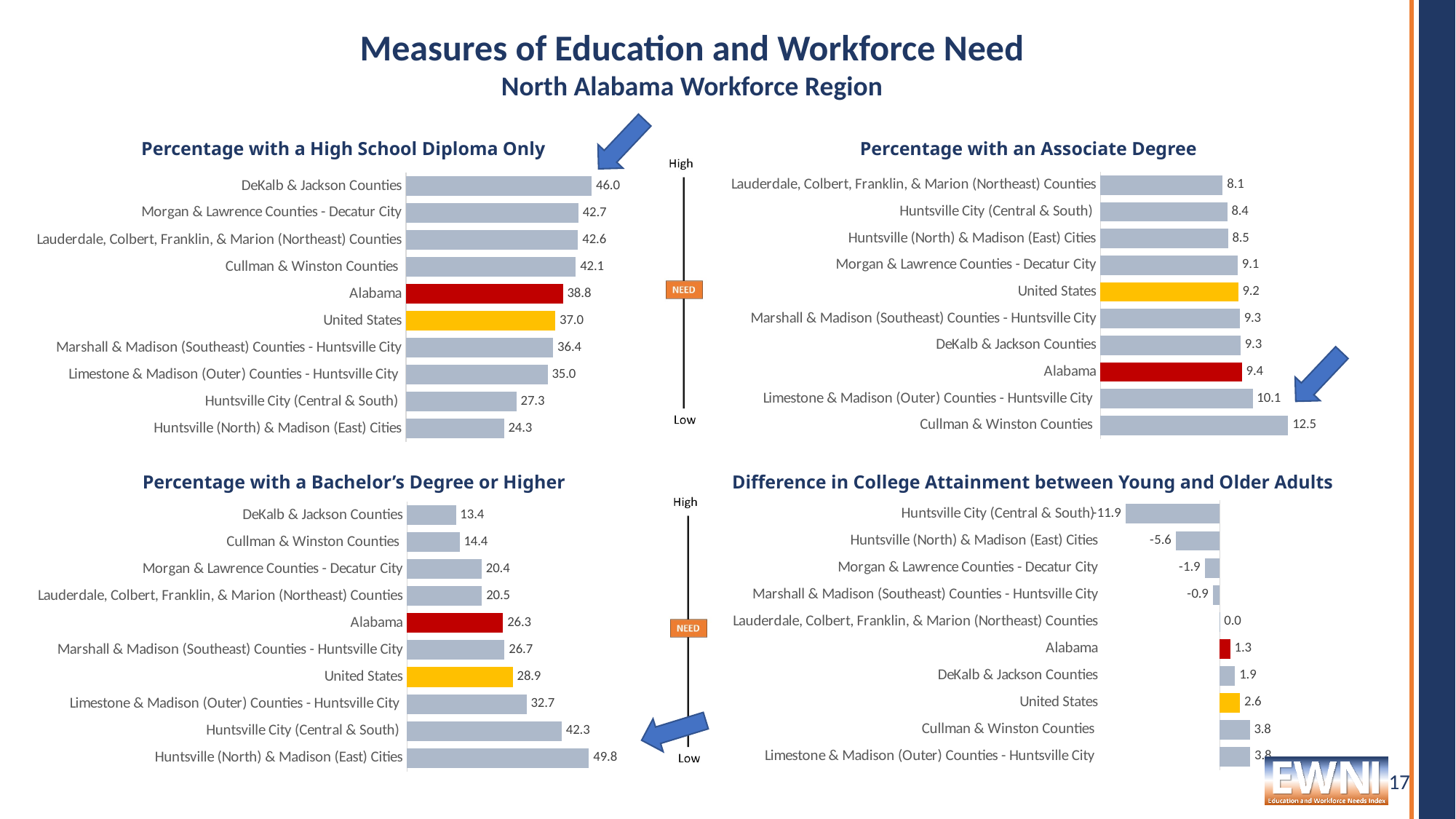
What type of chart is the 'Percentage with a High School Diploma Only' chart? Bar chart In the 'Percentage with an Associate Degree' chart, what is the value for Alabama? 9.4 In the 'Percentage with a High School Diploma Only' chart, what is the difference between Alabama and the United States? 1.8 In the 'Percentage with an Associate Degree' chart, how many categories are shown? 10 In the 'Difference in College Attainment between Young and Older Adults' chart, what is the value for Huntsville City (Central & South)? -11.9 In the 'Percentage with a Bachelor's Degree or Higher' chart, what is the value for Huntsville (North) & Madison (East) Cities? 49.8 In the 'Percentage with a Bachelor's Degree or Higher' chart, which is larger, the value for the United States or the value for Alabama? United States In the 'Percentage with a High School Diploma Only' chart, what is the value for DeKalb & Jackson Counties? 46.0 In the 'Percentage with an Associate Degree' chart, which category has the highest value? Cullman & Winston Counties In the 'Difference in College Attainment between Young and Older Adults' chart, what is the value for the United States? 2.6 In the 'Percentage with a High School Diploma Only' chart, which category has the lowest value? Huntsville (North) & Madison (East) Cities In the 'Percentage with a Bachelor's Degree or Higher' chart, what is the difference between Huntsville City (Central & South) and DeKalb & Jackson Counties? 28.9